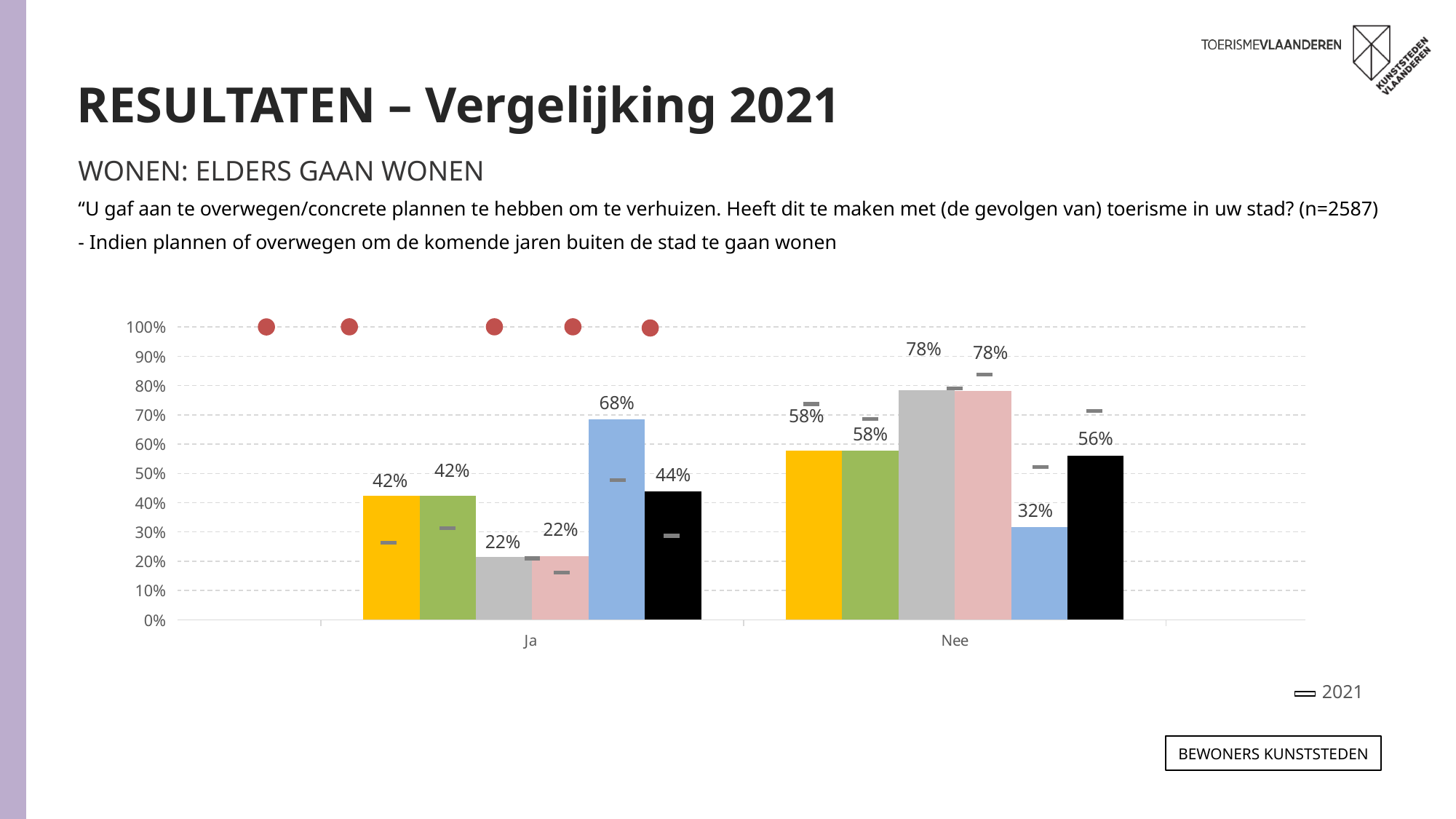
How many categories are shown on the x axis? 2 What is the value of the grey bar for the 'Nee' category? 78% Which coloured bar is the highest within the 'Ja' category? The blue bar (68%) What is the value of the yellow bar for the 'Ja' category? 42% Is the 2021 marker for the blue bar in the 'Ja' category greater or less than 40%? greater Is the black bar larger for 'Ja' or for 'Nee'? Nee What kind of chart is shown on the slide? Bar chart What is the difference between the blue bar for 'Ja' and the blue bar for 'Nee'? 36 percentage points What entry does the chart legend list? 2021 What is the value of the black bar for the 'Nee' category? 56% Which coloured bar is the lowest within the 'Nee' category? The blue bar (32%) What is the value of the blue bar for the 'Ja' category? 68%